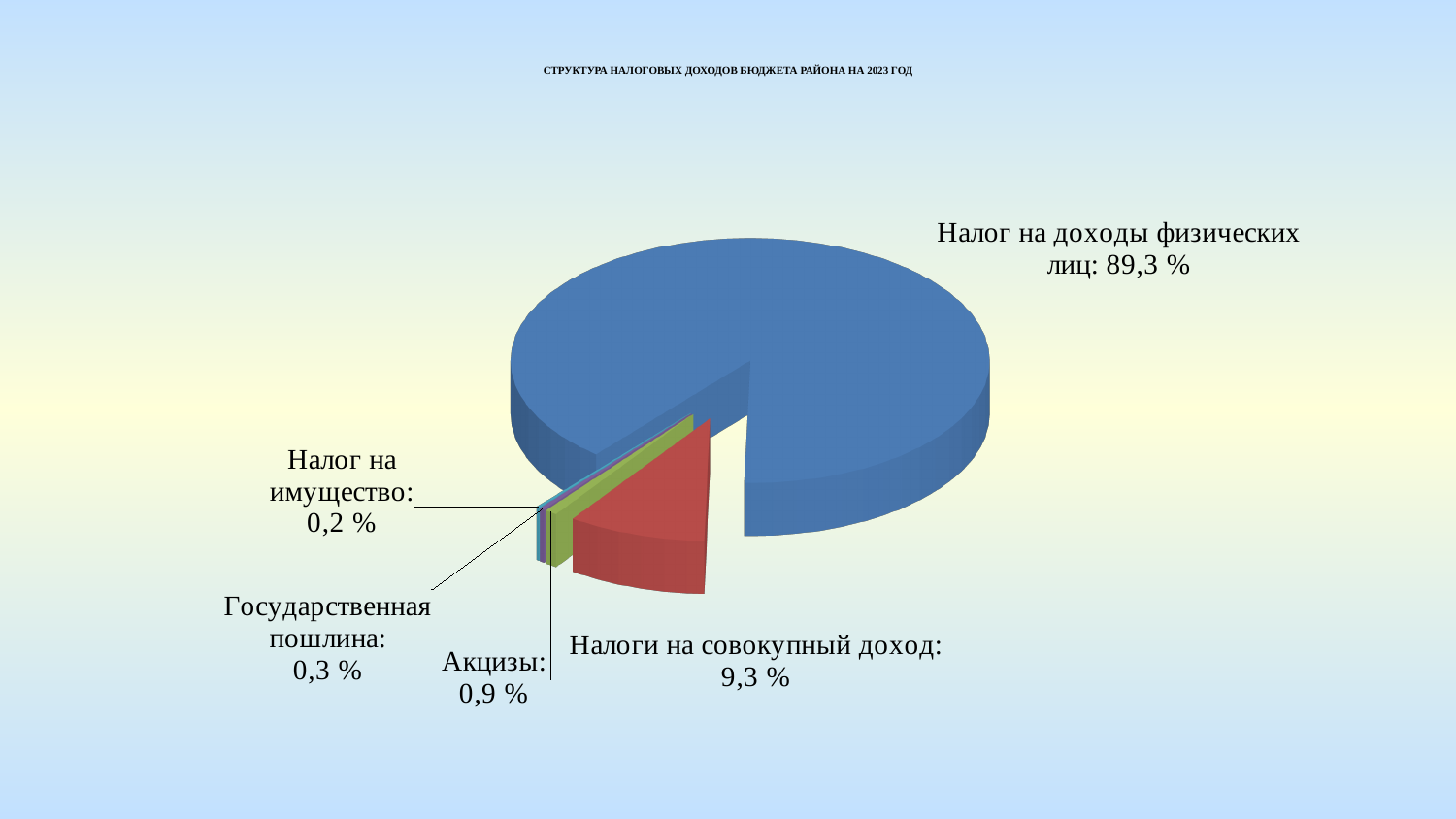
What is the value shown for "Акцизы"? 0,9 % How many categories are shown in the pie chart? 5 Which category has the smallest slice of the pie? Налог на имущество What kind of chart is shown on the slide? Pie chart What is the value shown for "Налог на имущество"? 0,2 % What is the title of the chart? СТРУКТУРА НАЛОГОВЫХ ДОХОДОВ БЮДЖЕТА РАЙОНА НА 2023 ГОД Which is larger: the share of "Акцизы" or the share of "Государственная пошлина"? Акцизы What share of the pie does "Налог на доходы физических лиц" have? 89,3 % What is the value shown for "Налоги на совокупный доход"? 9,3 % Which category has the largest slice of the pie? Налог на доходы физических лиц What is the difference between the shares of "Налог на доходы физических лиц" and "Налоги на совокупный доход"? 80,0 % What is the value shown for "Государственная пошлина"? 0,3 %